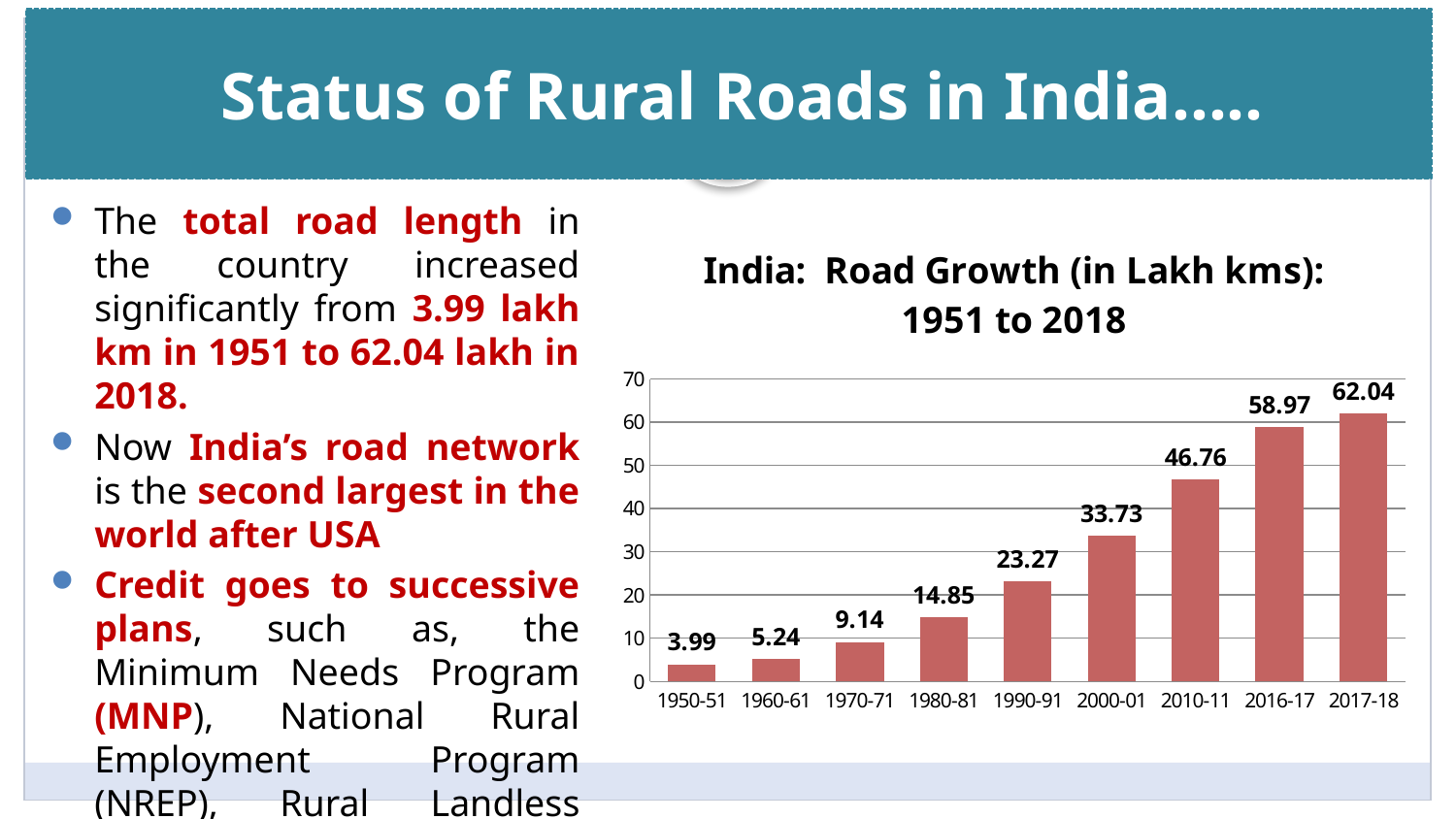
How many years are shown on the x axis of the chart? 9 Which year has the highest road length in the chart? 2017-18 Which year has the lowest road length in the chart? 1950-51 What is the title of the chart? India: Road Growth (in Lakh kms): 1951 to 2018 What is the road length value shown for 2010-11? 46.76 What is the difference between the values for 2017-18 and 2016-17? 3.07 What is the road length value shown for 1990-91? 23.27 What is the difference between the values for 2000-01 and 1990-91? 10.46 What kind of chart is shown on the slide? bar chart Which is larger, the value for 1980-81 or the value for 1970-71? 1980-81 Do the values rise or fall from 1950-51 to 2017-18? rise Is the value for 2000-01 greater or less than 30? greater